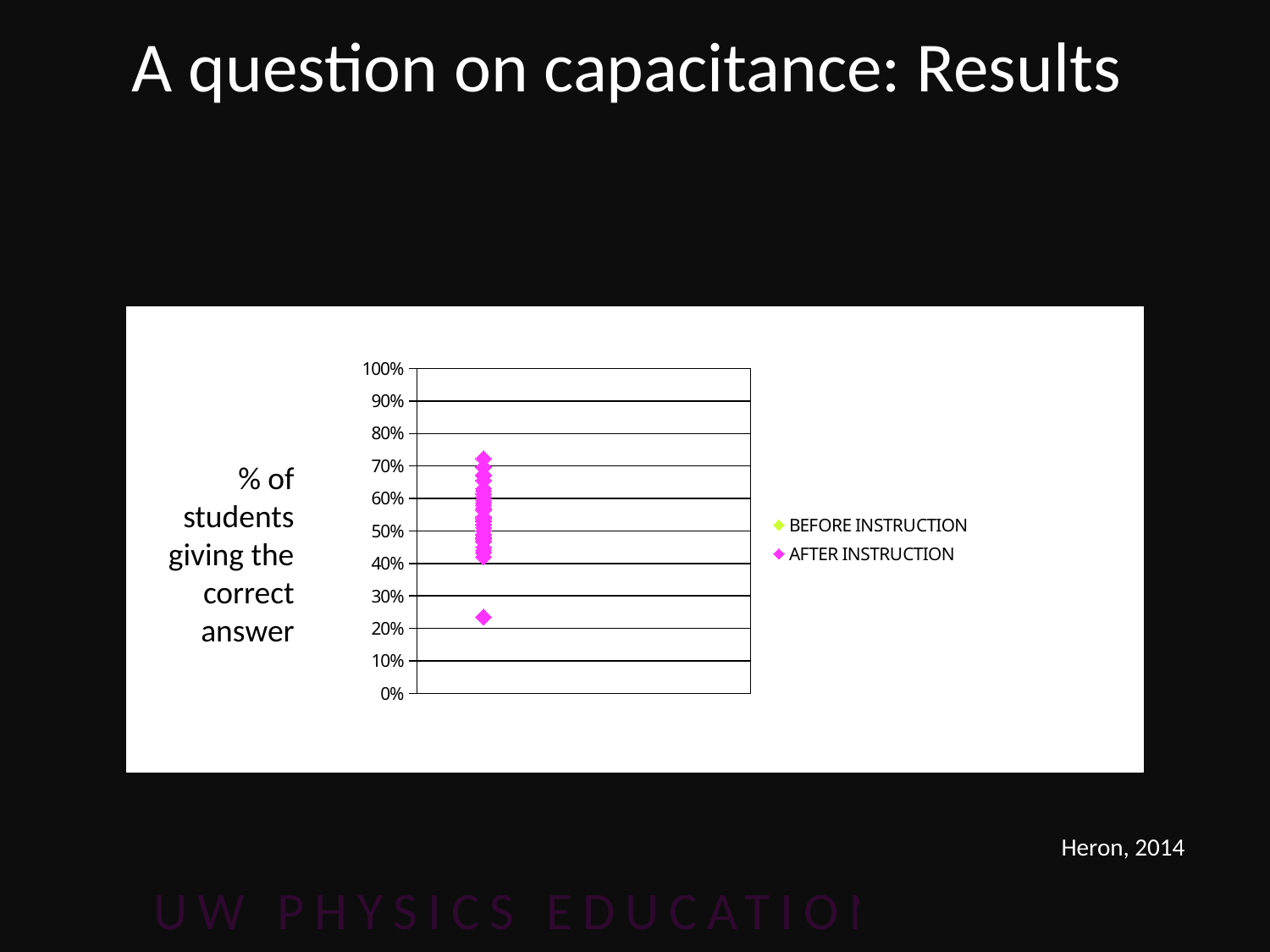
Are all of the plotted points below 100%? yes What are the two series named in the legend? BEFORE INSTRUCTION and AFTER INSTRUCTION Is the lowest plotted AFTER INSTRUCTION point greater or less than 10%? greater Is the lowest plotted AFTER INSTRUCTION point greater or less than 30%? less What is the title of the slide containing the chart? A question on capacitance: Results What is the maximum value shown on the vertical axis? 100% How many series does the legend list? 2 What kind of chart is shown on the slide? scatter chart